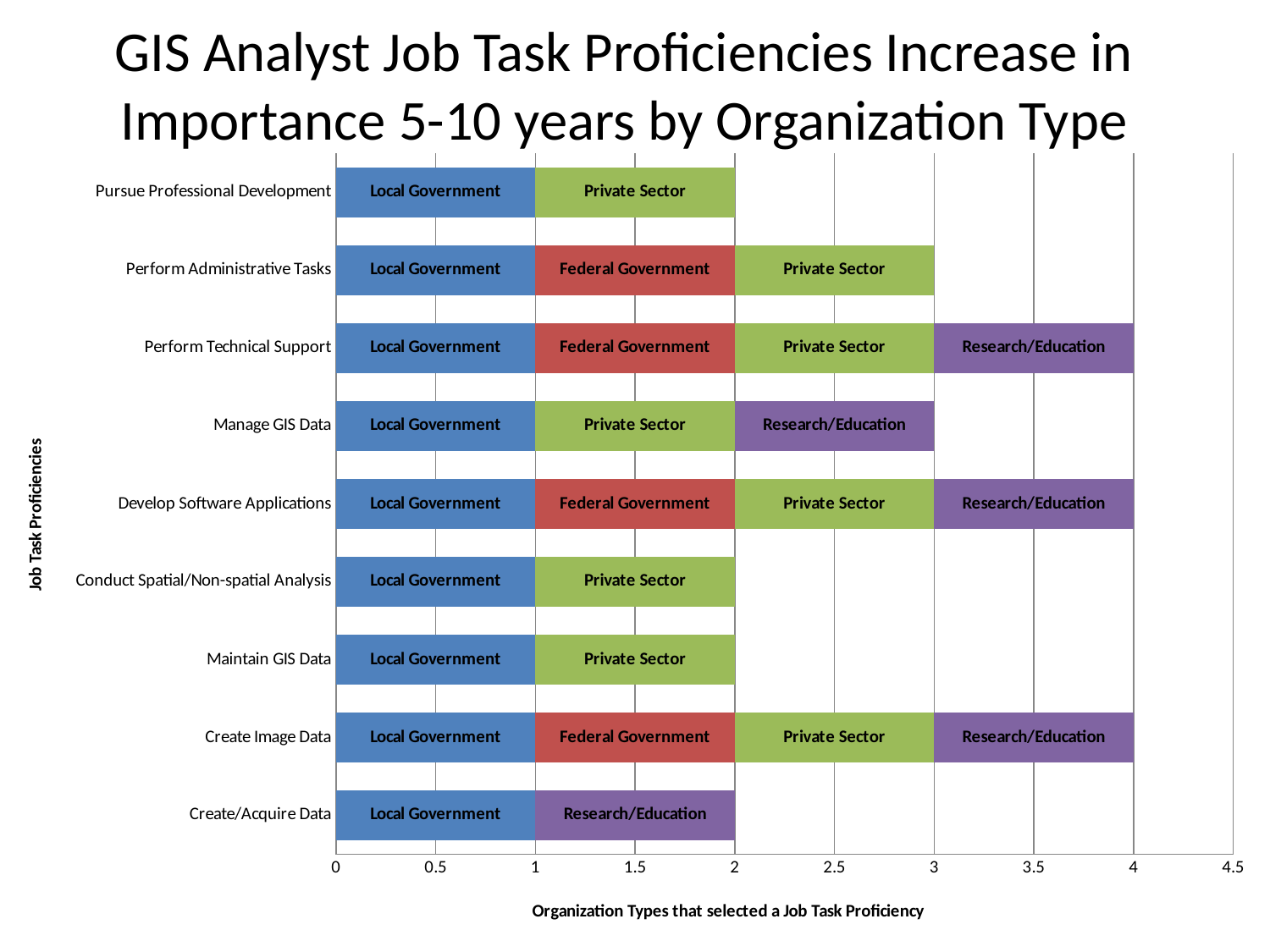
Which bar is longer: Create Image Data or Maintain GIS Data? Create Image Data How many job task proficiencies are listed on the vertical axis? 9 What is the label of the horizontal axis? Organization Types that selected a Job Task Proficiency Is the bar for Develop Software Applications greater or less than 3? greater Which organization types selected Create/Acquire Data? Local Government, Research/Education What kind of chart is shown on the slide? Stacked bar chart How many organization types selected Create/Acquire Data? 2 What is the difference between the number of organization types for Perform Technical Support and for Pursue Professional Development? 2 How many job task proficiencies were selected by all four organization types? 3 How many organization types selected Perform Technical Support? 4 How many organization types selected Manage GIS Data? 3 Which organization types selected Perform Administrative Tasks? Local Government, Federal Government, Private Sector